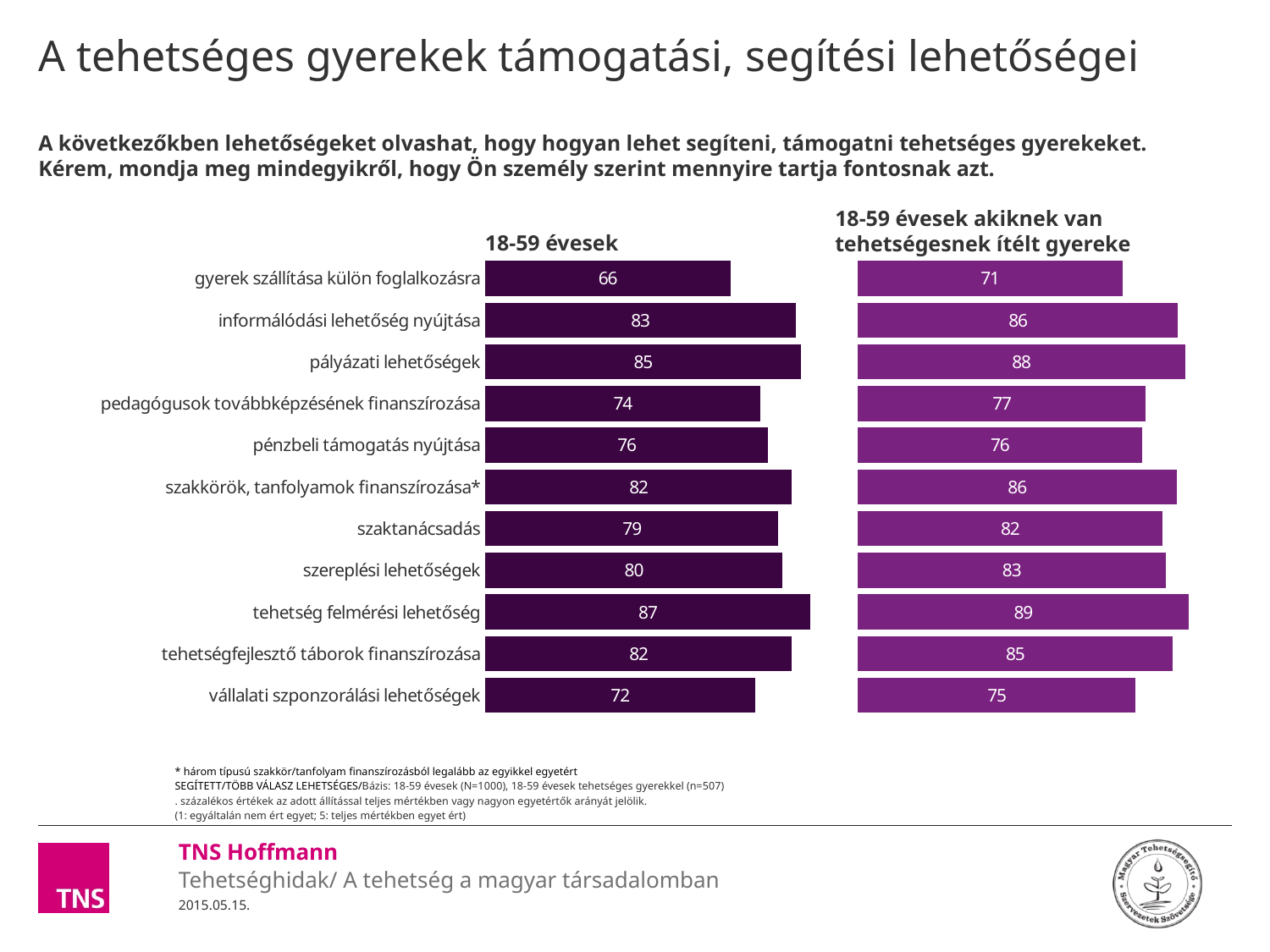
How many categories are shown in the "18-59 évesek" chart? 11 In the "18-59 évesek akiknek van tehetségesnek ítélt gyereke" chart, which category has the highest value? tehetség felmérési lehetőség What is the difference between the value for "gyerek szállítása külön foglalkozásra" in the right chart (18-59 évesek akiknek van tehetségesnek ítélt gyereke) and in the left chart (18-59 évesek)? 5 In the "18-59 évesek akiknek van tehetségesnek ítélt gyereke" chart, what is the value for "szaktanácsadás"? 82 In the "18-59 évesek" chart, which is larger: "pedagógusok továbbképzésének finanszírozása" or "pénzbeli támogatás nyújtása"? pénzbeli támogatás nyújtása What is the title of the chart on the right side of the slide? 18-59 évesek akiknek van tehetségesnek ítélt gyereke In the "18-59 évesek" chart, which category has the lowest value? gyerek szállítása külön foglalkozásra In the "18-59 évesek" chart, which category has the highest value? tehetség felmérési lehetőség What type of chart is used on this slide? bar chart In the "18-59 évesek" chart, what is the difference between "informálódási lehetőség nyújtása" and "vállalati szponzorálási lehetőségek"? 11 In the "18-59 évesek" chart, what is the value for "pályázati lehetőségek"? 85 In the "18-59 évesek akiknek van tehetségesnek ítélt gyereke" chart, which category has the lowest value? gyerek szállítása külön foglalkozásra